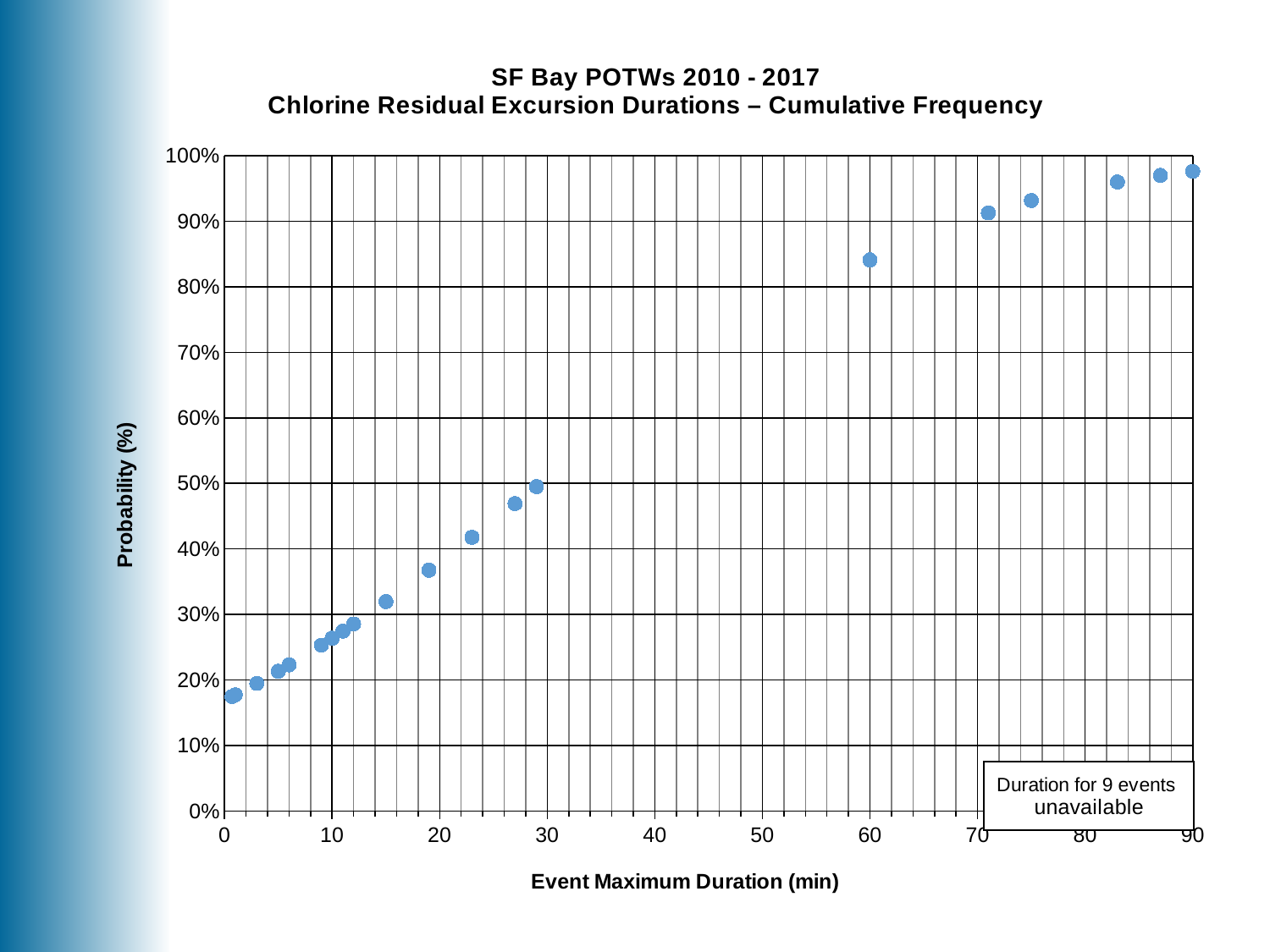
Is the probability for the point at an event maximum duration of 75 min greater or less than 90%? greater Do the probability values rise or fall as event maximum duration increases along the x axis? rise Is the probability for the point at an event maximum duration of 90 min greater or less than 90%? greater What kind of chart is shown on the slide? scatter chart Is the probability for the point at an event maximum duration of 19 min greater or less than 40%? less What is the label of the x axis? Event Maximum Duration (min) According to the note on the chart, for how many events is the duration unavailable? 9 Which has the higher probability: the point at 60 min or the point at 29 min? 60 min